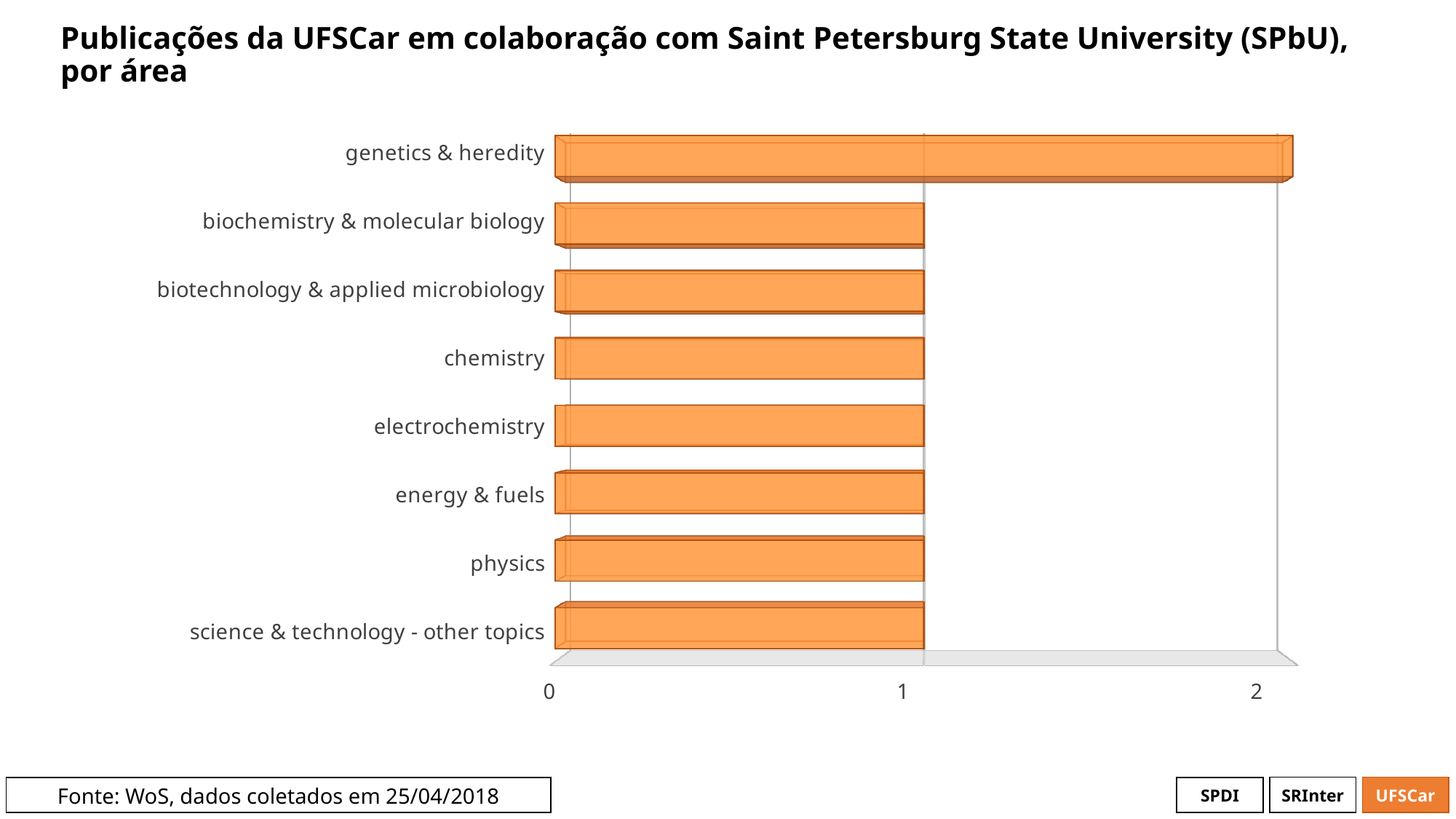
Is the value for biochemistry & molecular biology greater or less than 2? less What is the value for physics? 1 Which area has the highest number of publications? genetics & heredity What colour are the bars in the chart? orange What kind of chart is shown on the slide? bar chart Which is larger, the value for genetics & heredity or the value for electrochemistry? genetics & heredity What is the value for chemistry? 1 Is the value for genetics & heredity greater or less than 1? greater What is the value for genetics & heredity? 2 What is the difference between the value for genetics & heredity and the value for energy & fuels? 1 What is the title of the chart? Publicações da UFSCar em colaboração com Saint Petersburg State University (SPbU), por área How many areas (categories) are shown in the chart? 8